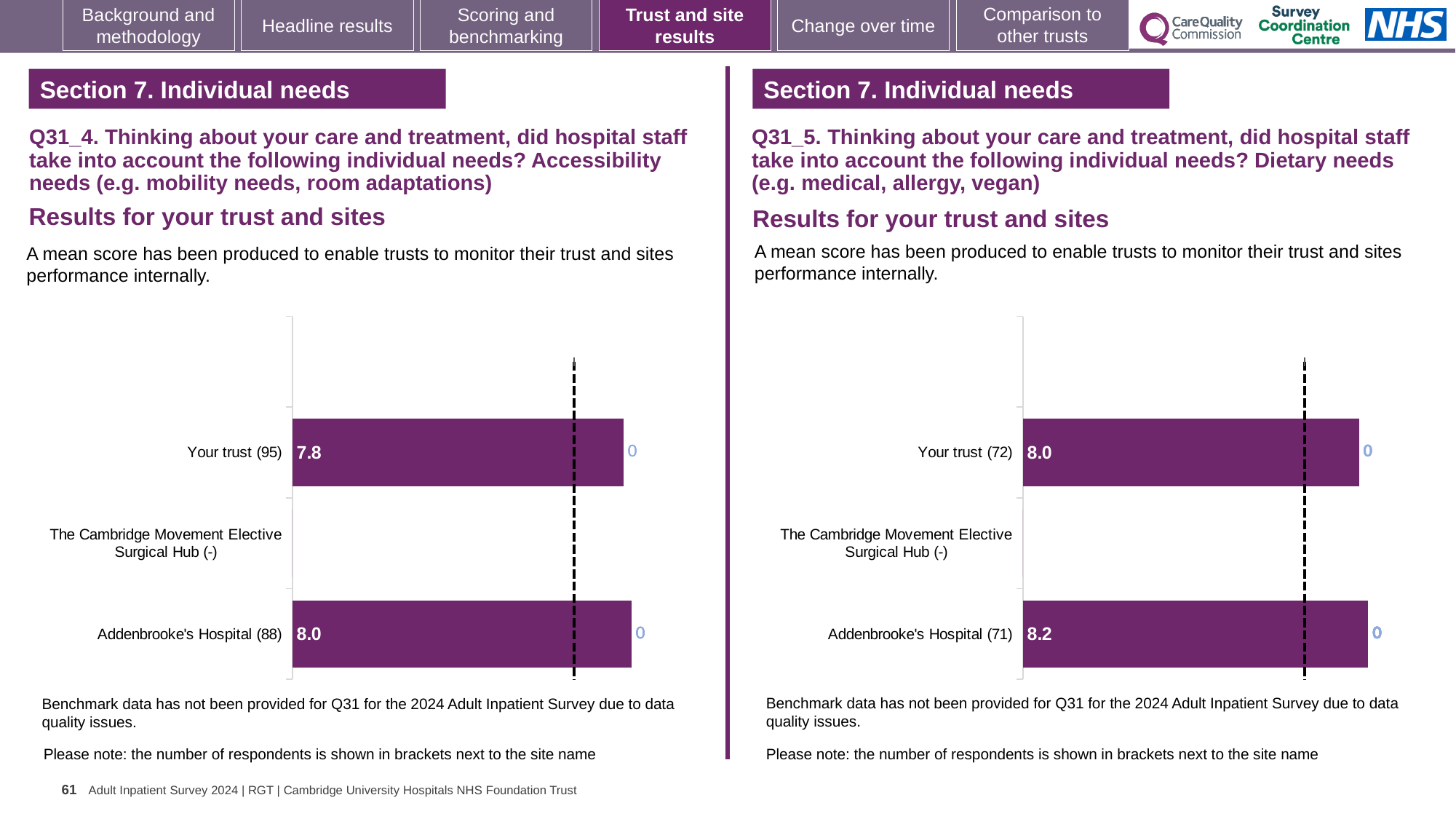
In the right chart (Q31_5, dietary needs), what is the mean score for Your trust? 8.0 How many categories are listed on the y axis of the right chart (Q31_5, dietary needs)? 3 In the left chart (Q31_4, accessibility needs), what is the mean score for Your trust? 7.8 In the left chart (Q31_4, accessibility needs), what is the difference between the mean scores for Addenbrooke's Hospital and Your trust? 0.2 In the left chart (Q31_4, accessibility needs), which site has the higher mean score, Your trust or Addenbrooke's Hospital? Addenbrooke's Hospital In the right chart (Q31_5, dietary needs), what is the difference between the mean scores for Addenbrooke's Hospital and Your trust? 0.2 In the right chart (Q31_5, dietary needs), which category has no bar plotted? The Cambridge Movement Elective Surgical Hub (-) In the left chart (Q31_4, accessibility needs), what is the mean score for Addenbrooke's Hospital? 8.0 In the right chart (Q31_5, dietary needs), what is the mean score for Addenbrooke's Hospital? 8.2 In the left chart (Q31_4, accessibility needs), how many respondents are shown in brackets for Your trust? 95 In the right chart (Q31_5, dietary needs), how many respondents are shown in brackets for Addenbrooke's Hospital? 71 What type of chart is used in the left chart (Q31_4, accessibility needs)? Bar chart